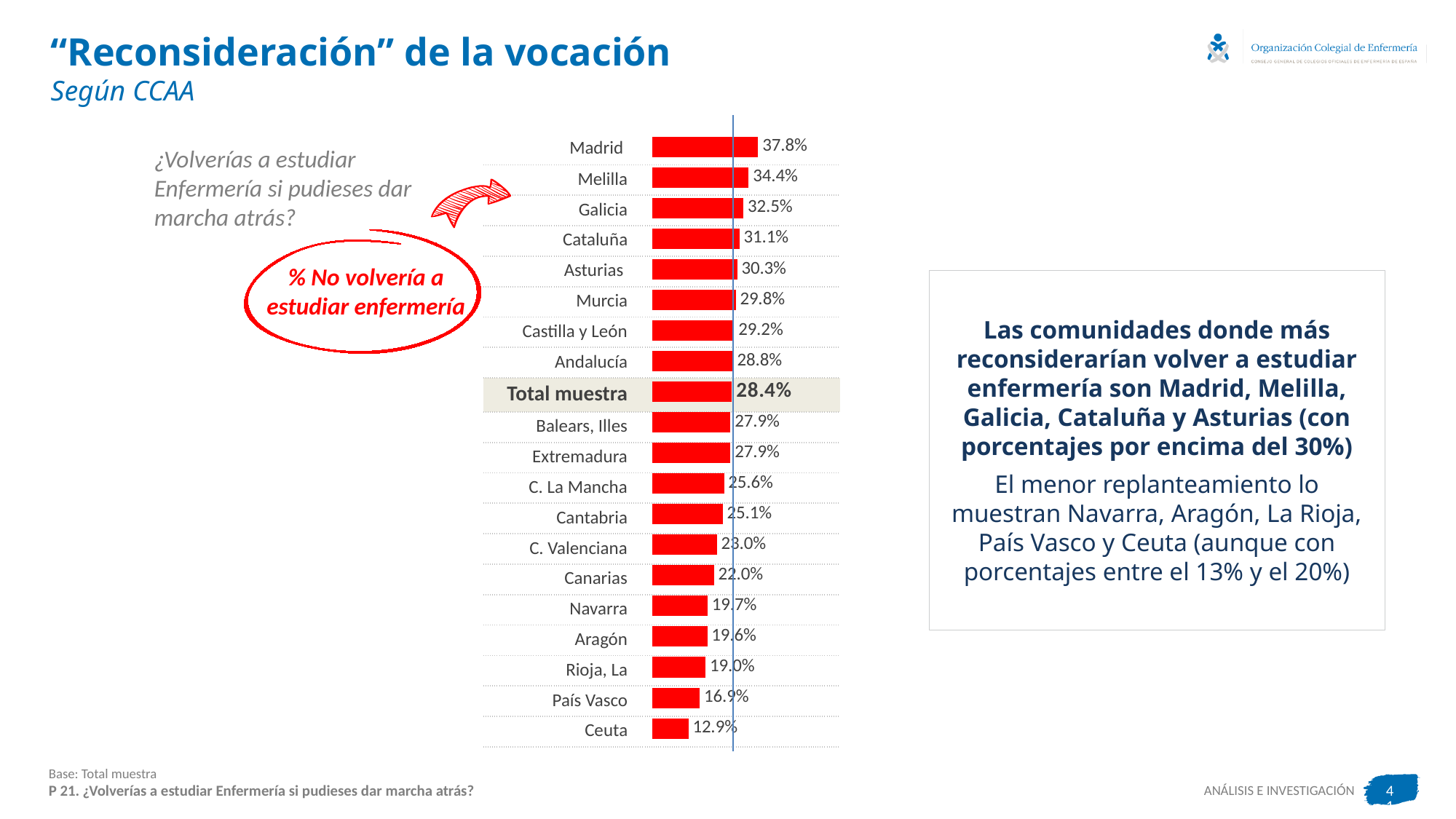
Which category has the highest value in the chart? Madrid Which has a higher value, Melilla or Asturias? Melilla What is the difference between the values for Madrid and Ceuta? 24.9 percentage points Which has a higher value, Navarra or Canarias? Canarias Which category has the lowest value in the chart? Ceuta What percentage is shown for Madrid? 37.8% What percentage is shown for País Vasco? 16.9% What kind of chart is shown on the slide? Bar chart What colour are the bars in the chart? Red What is the value for Total muestra? 28.4% How many categories (bars) are shown in the chart, including Total muestra? 20 What is the difference between the values for Galicia and Cataluña? 1.4 percentage points